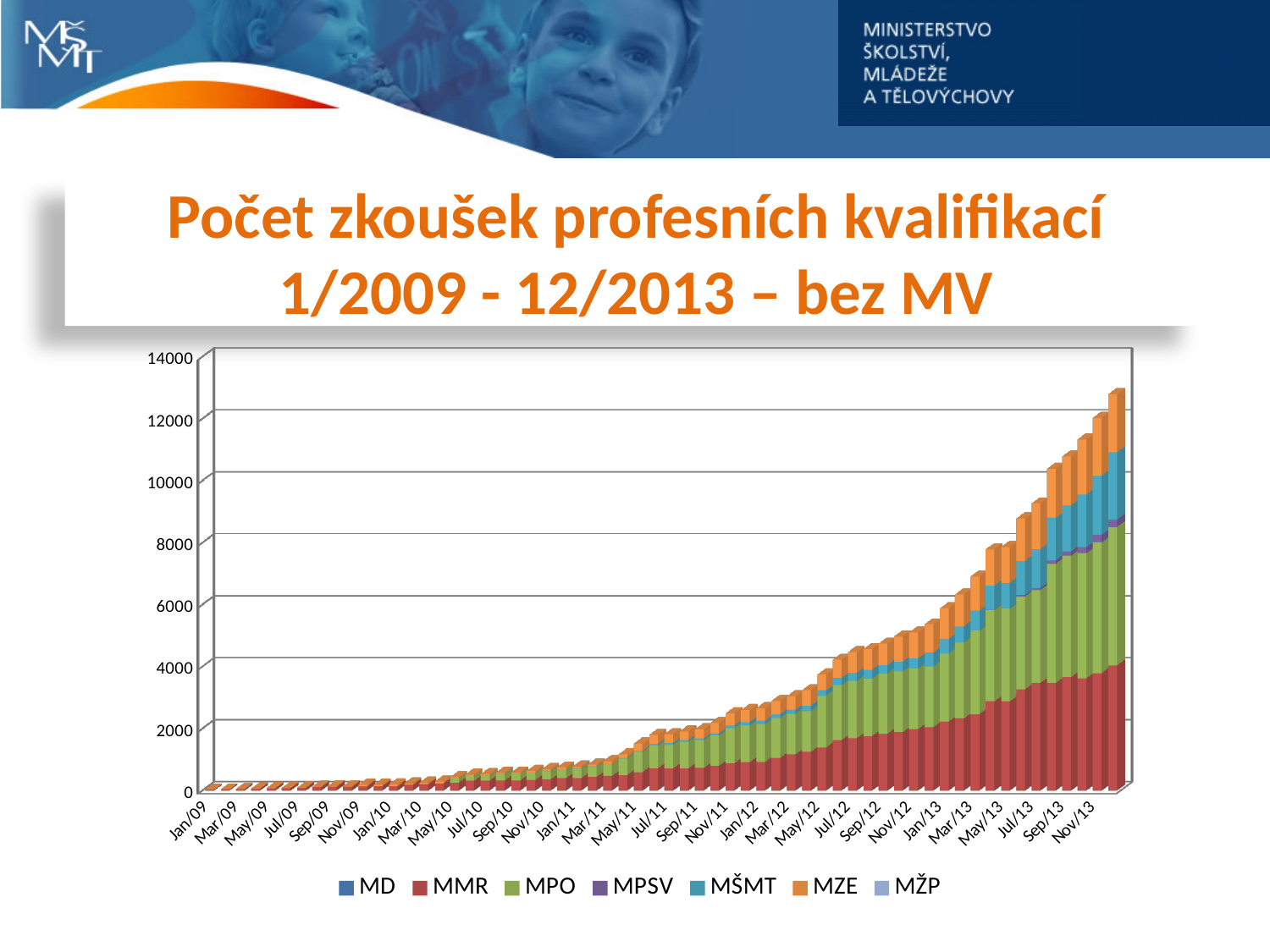
Which end of the x axis has the highest stacked totals, the left (2009) or the right (2013)? right (2013) Do the stacked totals rise or fall from Jan/09 to the end of 2013? rise Is the stacked total for May/12 greater or less than 4000? less In the Nov/13 bar, which segment is larger, MPO or MPSV? MPO How many series does the legend list? 7 Is the stacked total for Jan/11 greater or less than 2000? less Which colour represents the MZE series in the chart? orange In the Nov/13 bar, which segment is larger, MMR or MŠMT? MMR Is the stacked total for Jul/13 greater or less than 8000? greater What is the title of the chart on the slide? Počet zkoušek profesních kvalifikací 1/2009 - 12/2013 – bez MV What kind of chart is shown on the slide? stacked bar chart